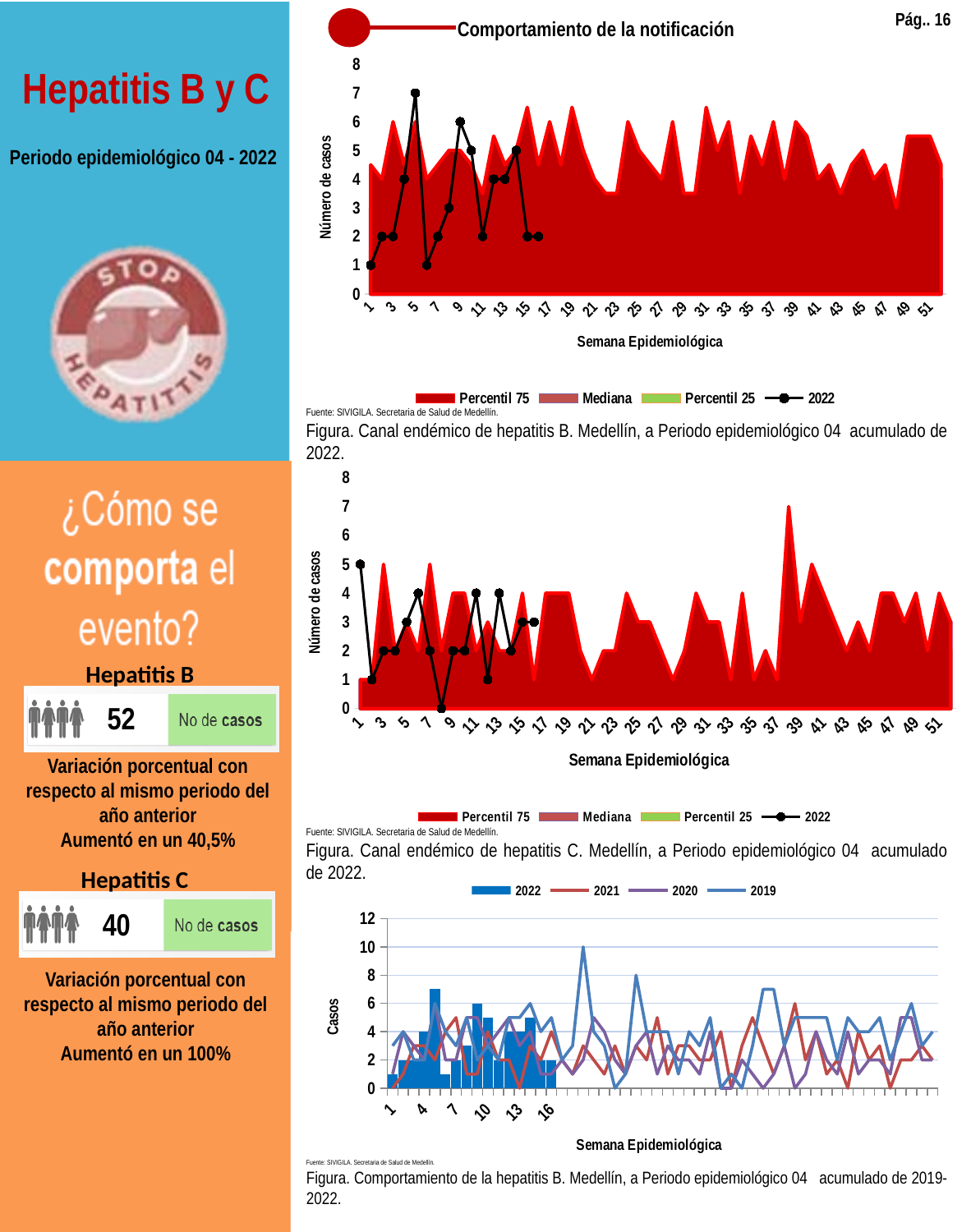
In the middle chart (Canal endémico de hepatitis C), what is the value of the 2022 line at week 1? 5 In the top chart (Canal endémico de hepatitis B), is the 2022 value at week 5 larger or the value at week 9? Week 5 In the top chart (Canal endémico de hepatitis B), at which week does the 2022 line reach its highest value? Week 5 In the top chart (Canal endémico de hepatitis B), what is the value of the 2022 line at week 5? 7 What is the x-axis title of the top chart (Canal endémico de hepatitis B)? Semana Epidemiológica In the bottom chart (Comportamiento de la hepatitis B 2019-2022), what kind of chart is used for the 2022 series? Bar chart In the bottom chart (Comportamiento de la hepatitis B 2019-2022), what is the highest value reached by the 2019 line? 10 In the top chart (Canal endémico de hepatitis B), what is the value of the 2022 line at week 1? 1 In the middle chart (Canal endémico de hepatitis C), what is the lowest value reached by the 2022 line? 0 In the top chart (Canal endémico de hepatitis B), how many series does the legend list? 4 In the top chart (Canal endémico de hepatitis B), how many weeks have a plotted 2022 value? 16 In the bottom chart (Comportamiento de la hepatitis B 2019-2022), is the 2022 bar at week 5 greater or less than 6? greater